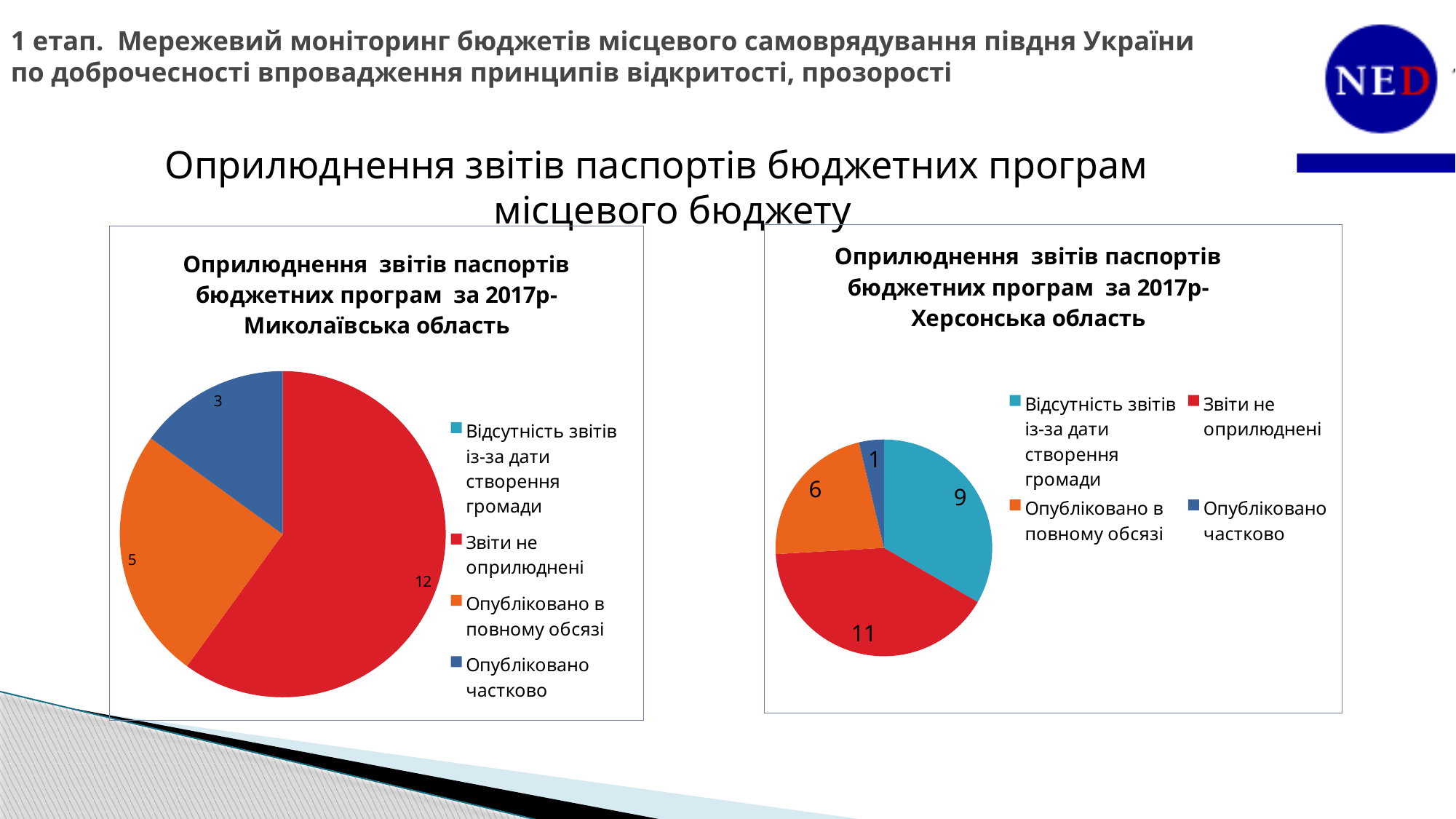
In the Херсонська область chart, which category has the largest slice? Звіти не оприлюднені In the Херсонська область chart, what is the difference between Звіти не оприлюднені and Опубліковано в повному обсязі? 5 In the Миколаївська область chart, what is the value for Опубліковано в повному обсязі? 5 In the Миколаївська область chart, which is larger: Опубліковано в повному обсязі or Опубліковано частково? Опубліковано в повному обсязі In the Миколаївська область chart, what share of the pie does Звіти не оприлюднені represent? 60% In the Херсонська область chart, what is the value for Опубліковано частково? 1 What kind of chart is used for the Миколаївська область data? pie chart How many entries does the legend of the Херсонська область chart list? 4 In the Херсонська область chart, what is the value for Відсутність звітів із-за дати створення громади? 9 In the Херсонська область chart, which category has the smallest slice? Опубліковано частково In the Миколаївська область chart, what is the value for Опубліковано частково? 3 In the Миколаївська область chart, what is the value for Звіти не оприлюднені? 12